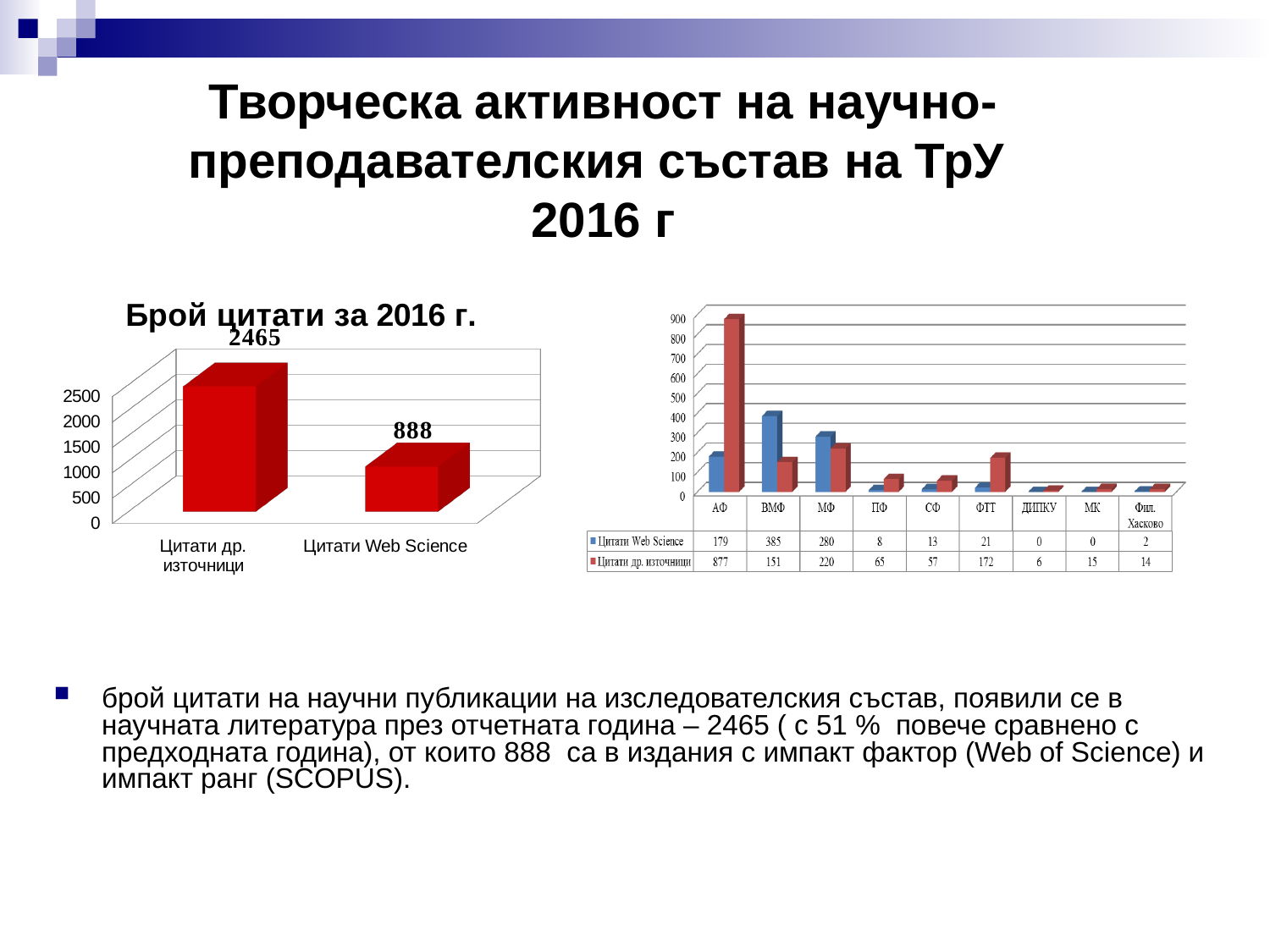
In the chart titled "Брой цитати за 2016 г.", what is the value for "Цитати др. източници"? 2465 In the chart on the right, which category has the highest value for "Цитати Web Science"? ВМФ In the chart on the right, which is larger for МФ: "Цитати Web Science" or "Цитати др. източници"? Цитати Web Science In the chart on the right, what is the difference between "Цитати др. източници" and "Цитати Web Science" for ФТТ? 151 In the chart on the right, how many categories are shown on the x axis? 9 In the chart titled "Брой цитати за 2016 г.", what is the difference between the two bars? 1577 In the chart titled "Брой цитати за 2016 г.", how many categories are shown? 2 In the chart titled "Брой цитати за 2016 г.", what is the value for "Цитати Web Science"? 888 In the chart on the right, what is the value of "Цитати Web Science" for ВМФ? 385 In the chart on the right, how many series does the legend list? 2 In the chart on the right, what is the value of "Цитати др. източници" for АФ? 877 In the chart on the right, which category has the highest value for "Цитати др. източници"? АФ